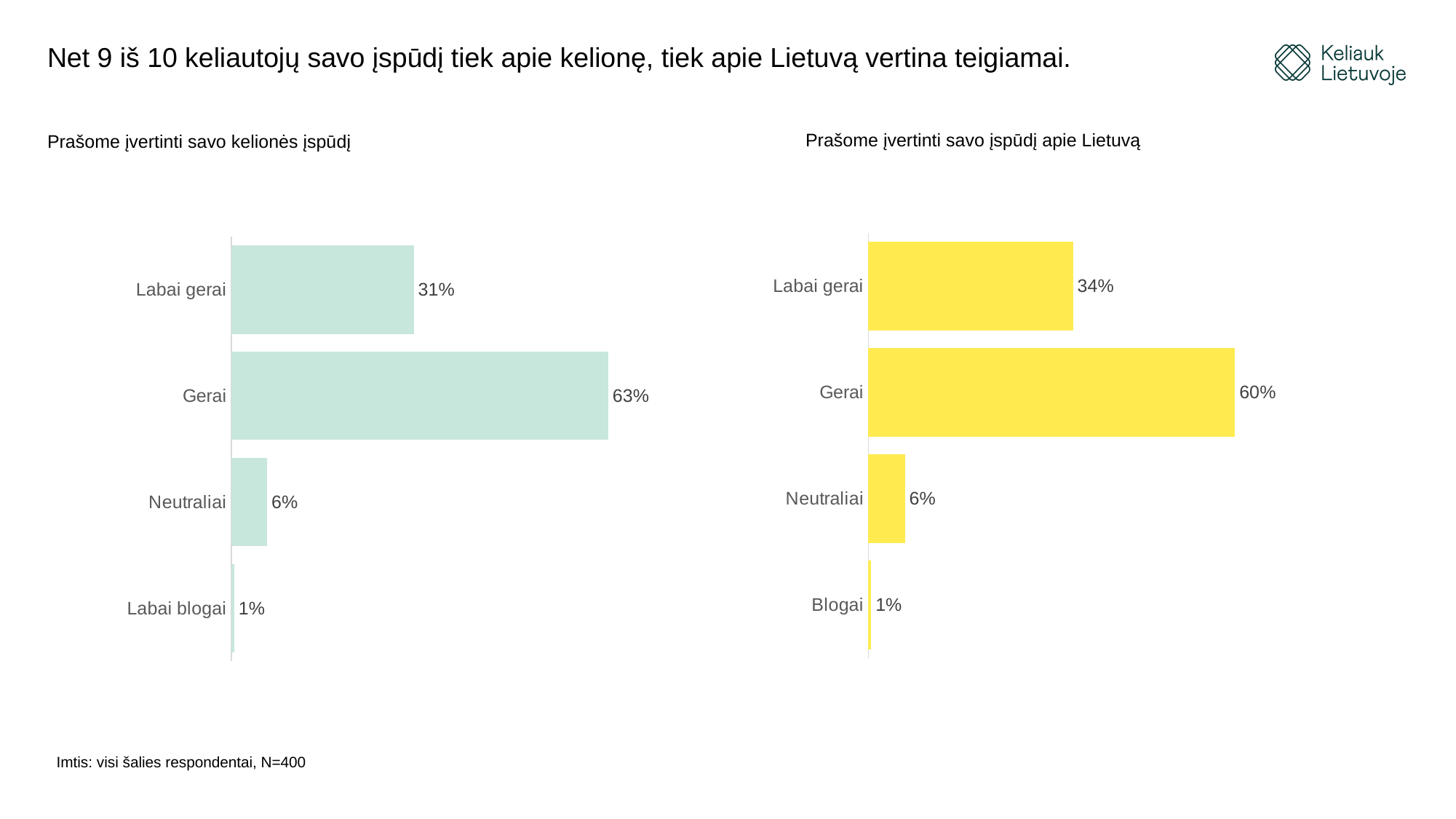
In the left chart (Prašome įvertinti savo kelionės įspūdį), what is the value for Labai blogai? 1% In the right chart (Prašome įvertinti savo įspūdį apie Lietuvą), which is larger, Neutraliai or Blogai? Neutraliai What type of chart is the right chart (Prašome įvertinti savo įspūdį apie Lietuvą)? Bar chart In the left chart (Prašome įvertinti savo kelionės įspūdį), what is the difference between Gerai and Labai gerai? 32% Which is larger: Labai gerai in the left chart or Labai gerai in the right chart? Labai gerai in the right chart In the right chart (Prašome įvertinti savo įspūdį apie Lietuvą), what is the value for Labai gerai? 34% In the left chart (Prašome įvertinti savo kelionės įspūdį), which category has the lowest value? Labai blogai In the left chart (Prašome įvertinti savo kelionės įspūdį), what is the value for Gerai? 63% What colour are the bars in the right chart (Prašome įvertinti savo įspūdį apie Lietuvą)? Yellow In the right chart (Prašome įvertinti savo įspūdį apie Lietuvą), which category has the highest value? Gerai In the right chart (Prašome įvertinti savo įspūdį apie Lietuvą), what is the difference between Gerai and Neutraliai? 54% How many categories does the left chart (Prašome įvertinti savo kelionės įspūdį) show? 4